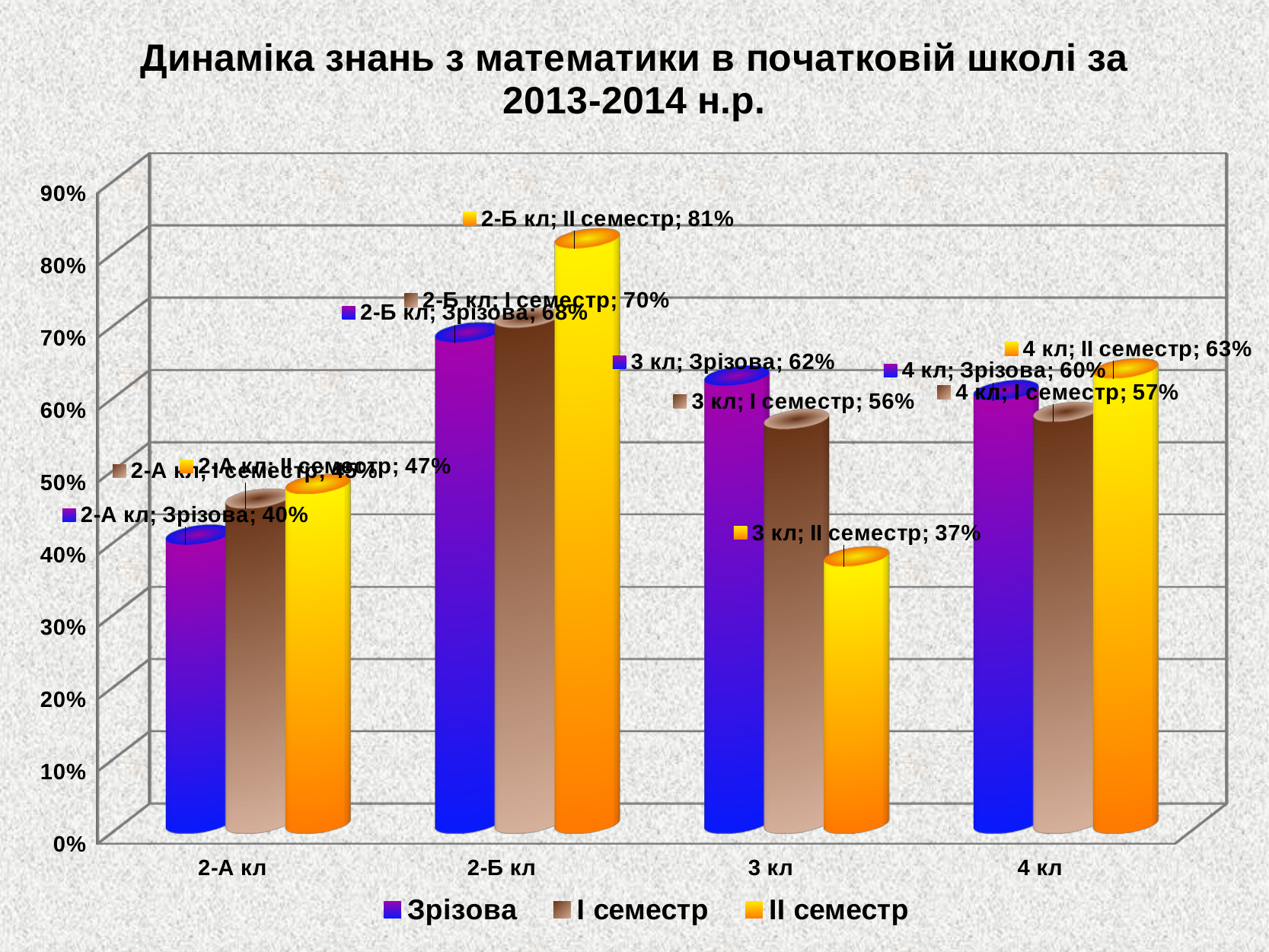
For 2-Б кл, what is the difference between the ІІ семестр value and the Зрізова value? 13 percentage points How many series does the legend list? 3 What is the value for 2-А кл in the Зрізова series? 40% For 3 кл, which is larger: the Зрізова value or the І семестр value? Зрізова What is the value for 4 кл in the Зрізова series? 60% What is the value for 3 кл in the ІІ семестр series? 37% Is the Зрізова value for 2-А кл greater or less than 50%? less What is the value for 2-Б кл in the ІІ семестр series? 81% Which class has the highest value in the ІІ семестр series? 2-Б кл How many classes are shown on the x axis? 4 Which class has the lowest value in the ІІ семестр series? 3 кл What kind of chart is shown on the slide? bar chart